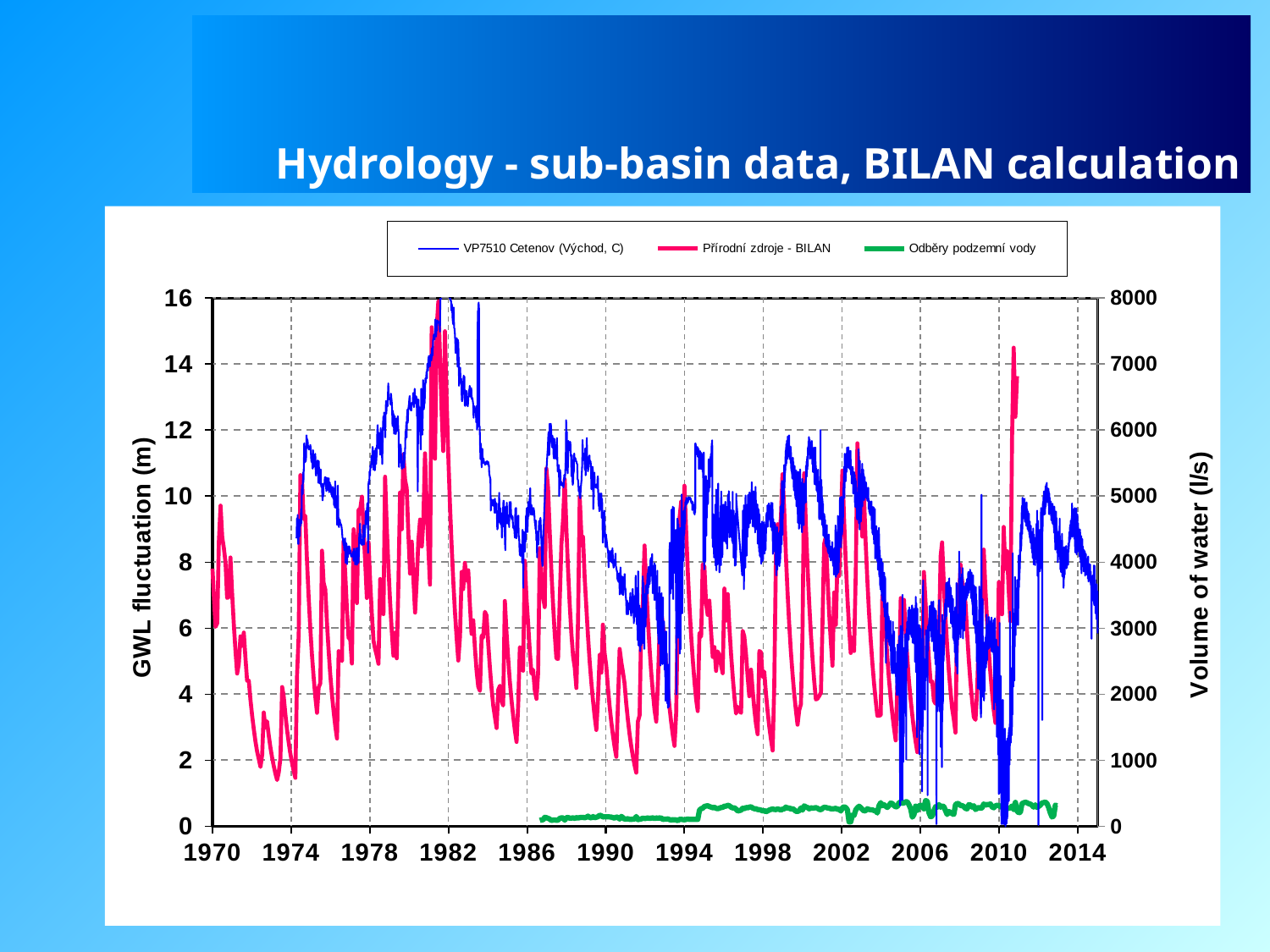
Is the value of the VP7510 Cetenov (Východ, C) series in 1982 greater or less than 12 m on the left axis? greater What kind of chart is shown on the slide? line chart Does the Odběry podzemní vody series rise or fall between 1988 and 1996? rise What is the title of the right-hand vertical axis? Volume of water (l/s) Is the peak of the Přírodní zdroje - BILAN series around 1981 greater or less than 6000 on the right axis? greater Which series is drawn in green according to the legend? Odběry podzemní vody How many series does the legend list? 3 Is the value of the Odběry podzemní vody series in 2000 greater or less than 1000 on the right axis? less Does the Přírodní zdroje - BILAN series rise or fall between 1970 and 1973? fall Does the VP7510 Cetenov (Východ, C) series generally rise or fall between 1982 and 1992? fall